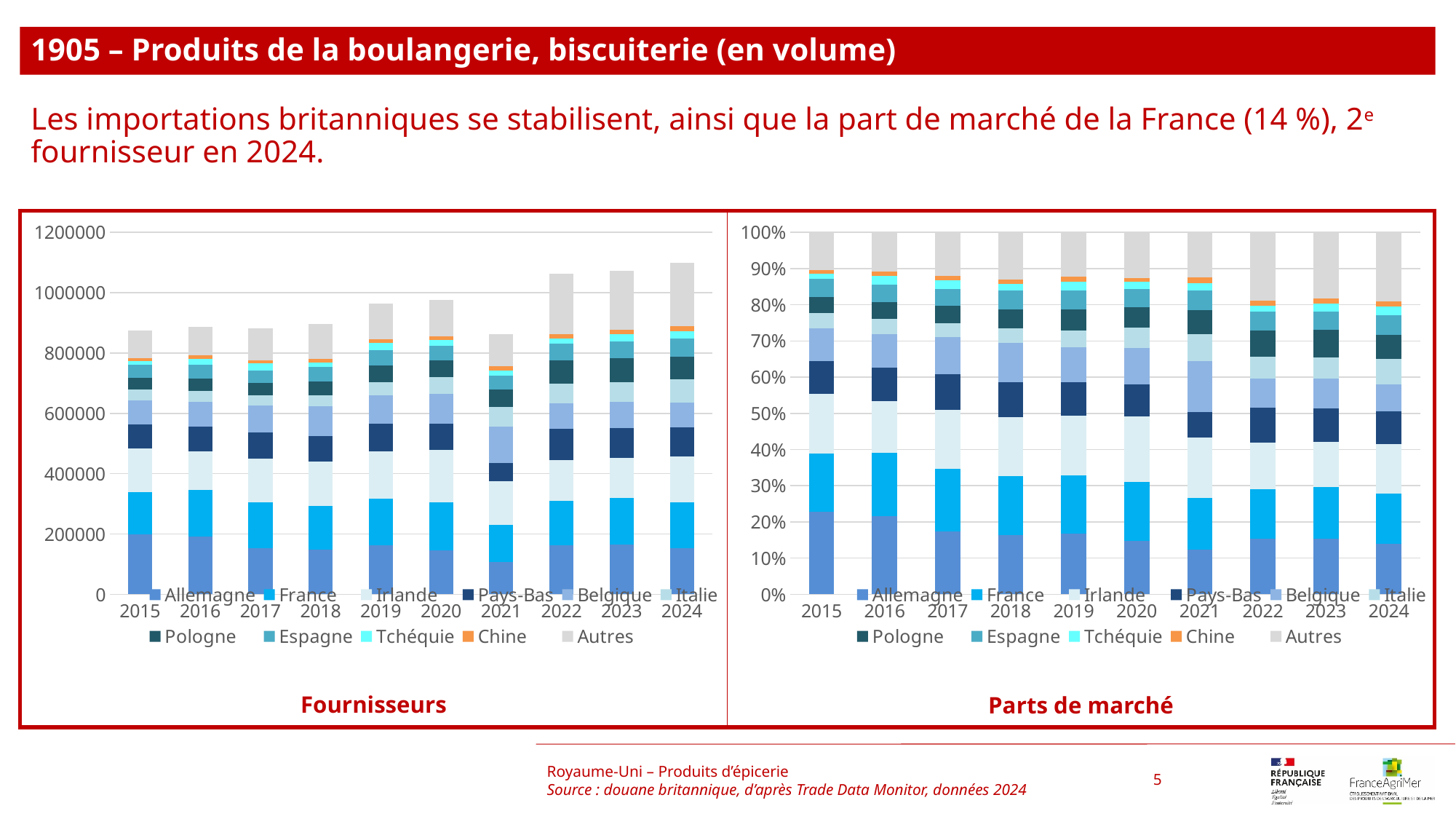
In the 'Fournisseurs' chart, is the total for 2024 greater or less than 1000000? greater In the 'Parts de marché' chart, is the share of Allemagne in 2015 greater or less than 20%? greater In the 'Fournisseurs' chart, do the total bars generally rise or fall from 2015 to 2024? rise How many years are shown on the x axis of the 'Parts de marché' chart? 10 What kind of chart is the 'Fournisseurs' chart on the left? stacked bar chart In the 'Fournisseurs' chart, which year has the highest total bar? 2024 In the 'Parts de marché' chart, is the share of Allemagne larger in 2015 or in 2024? 2015 In the 'Fournisseurs' chart, is the total for 2015 greater or less than 800000? greater How many series does the legend of the 'Fournisseurs' chart list? 11 In the 'Fournisseurs' chart, which total is larger, 2015 or 2024? 2024 What is the title of the chart on the right of the slide? Parts de marché